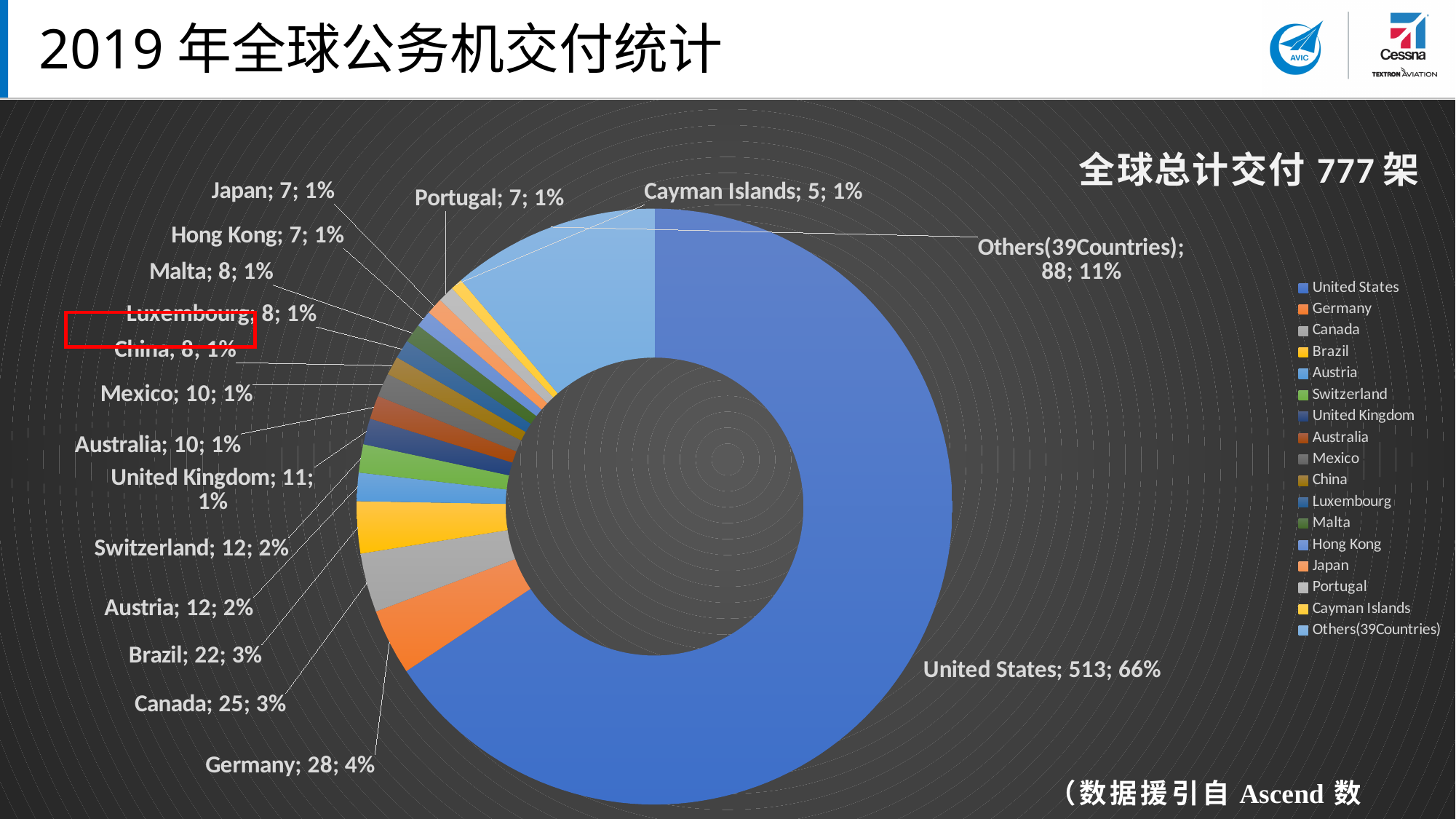
What is the total number of deliveries stated on the slide? 777 Which is larger, the value for Brazil or the value for Austria? Brazil How many categories does the chart legend list? 17 What value is shown for Others(39Countries)? 88 Which category has the smallest value in the chart? Cayman Islands Which category has the largest value in the chart? United States How many deliveries does the chart show for Germany? 28 What kind of chart is shown on the slide? Doughnut (pie) chart What share of the pie does Others(39Countries) represent? 11% What is the difference between the values for Germany and Canada? 3 What share of the pie does the United States slice represent? 66% How many business jets were delivered to the United States according to the chart? 513